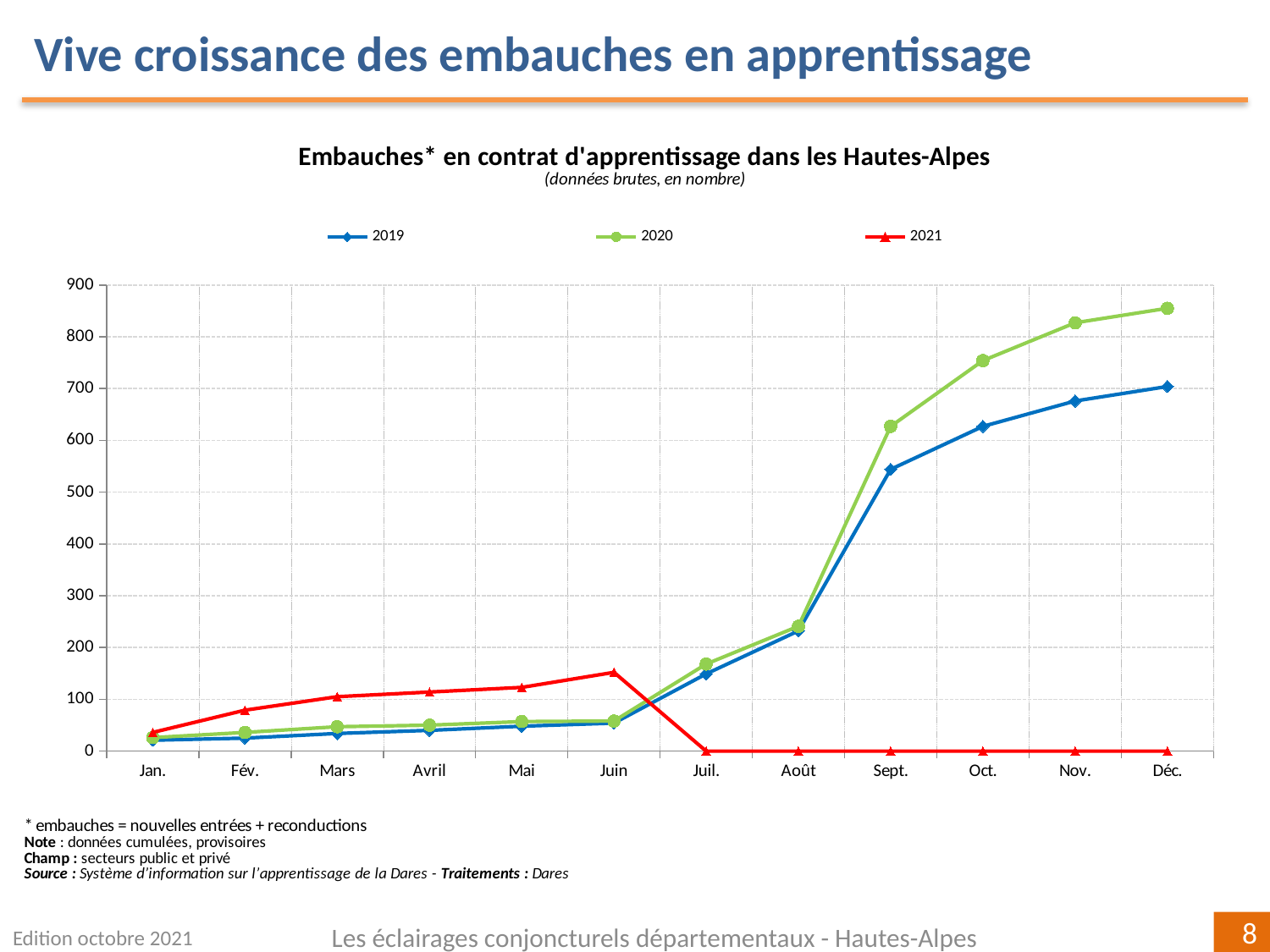
Is the value for 2020 in Déc. greater or less than 800? greater What is the title of the chart? Embauches* en contrat d'apprentissage dans les Hautes-Alpes In Juin, which series has the higher value, 2019 or 2021? 2021 What kind of chart is shown on the slide? line chart In Déc., which series has the higher value, 2019 or 2020? 2020 In which month does the 2020 series reach its highest value? Déc. Is the value for 2021 in Juin greater or less than 100? greater How many series does the legend list? 3 Is the value for 2020 in Oct. greater or less than 700? greater Do the values of the 2020 series rise or fall from Jan. to Déc.? rise How many months are shown along the x axis? 12